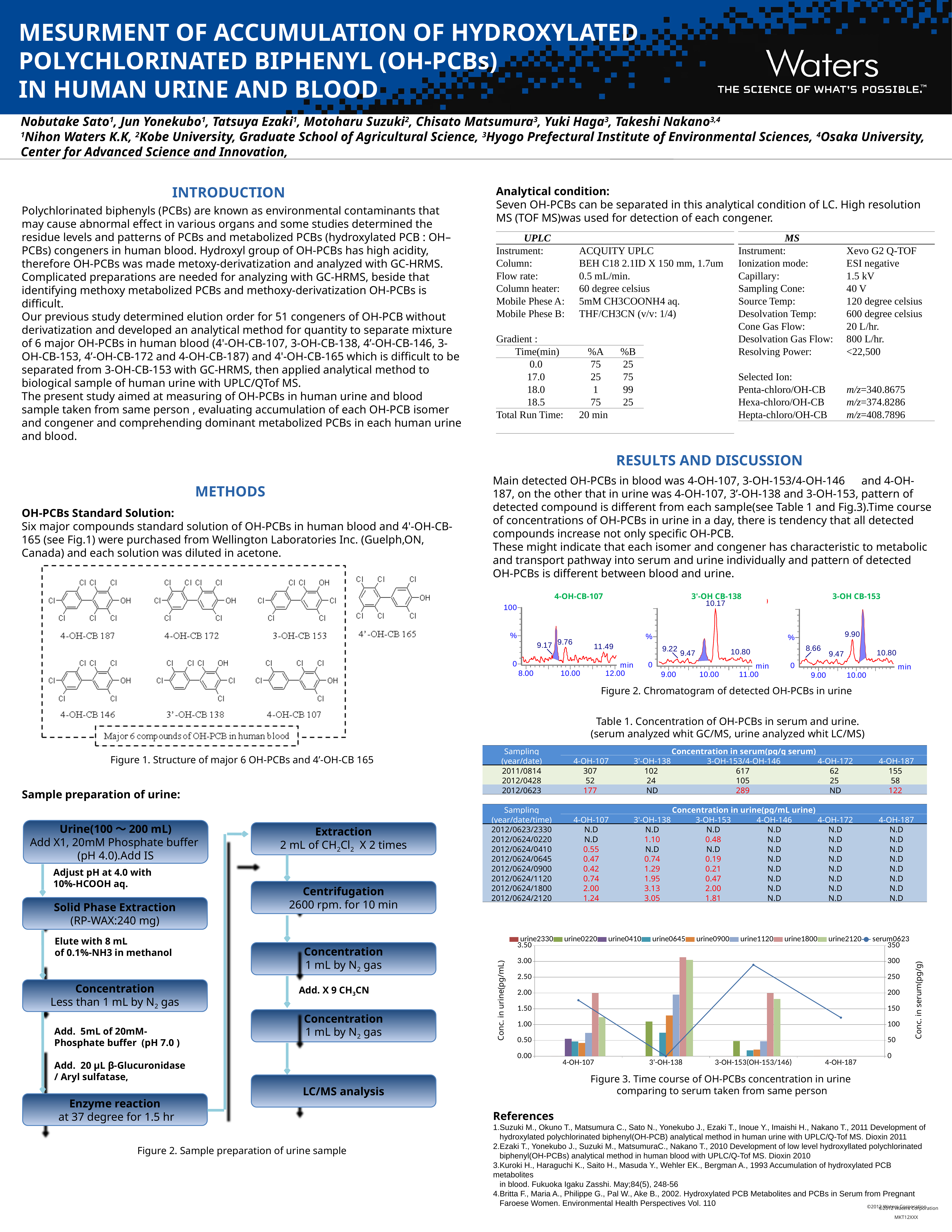
In Figure 3, which category has the lowest serum0623 value? 3'-OH-138 In the 3'-OH CB-138 chromatogram of Figure 2, what retention time is labelled on the tallest peak? 10.17 In Figure 3, is the urine1800 bar for 3'-OH-138 greater or less than 2.50? greater In Figure 3, how many OH-PCB categories are shown on the x axis? 4 In Figure 3, which category has the highest serum0623 value? 3-OH-153(OH-153/146) In Figure 3, which is larger for 4-OH-107: the urine1800 bar or the urine2120 bar? urine1800 In Figure 3, is the serum0623 value for 4-OH-107 greater or less than 200 on the right axis? less In Figure 3, which is larger for 3'-OH-138: the urine1120 bar or the urine0900 bar? urine1120 In Figure 3, what is the title of the left vertical axis? Conc. in urine(pg/mL) In Figure 3, is the serum0623 value for 3-OH-153(OH-153/146) greater or less than 250 on the right axis? greater In Figure 3, what kind of chart is used to show the urine concentrations? bar chart In Figure 3, how many series does the legend list? 9